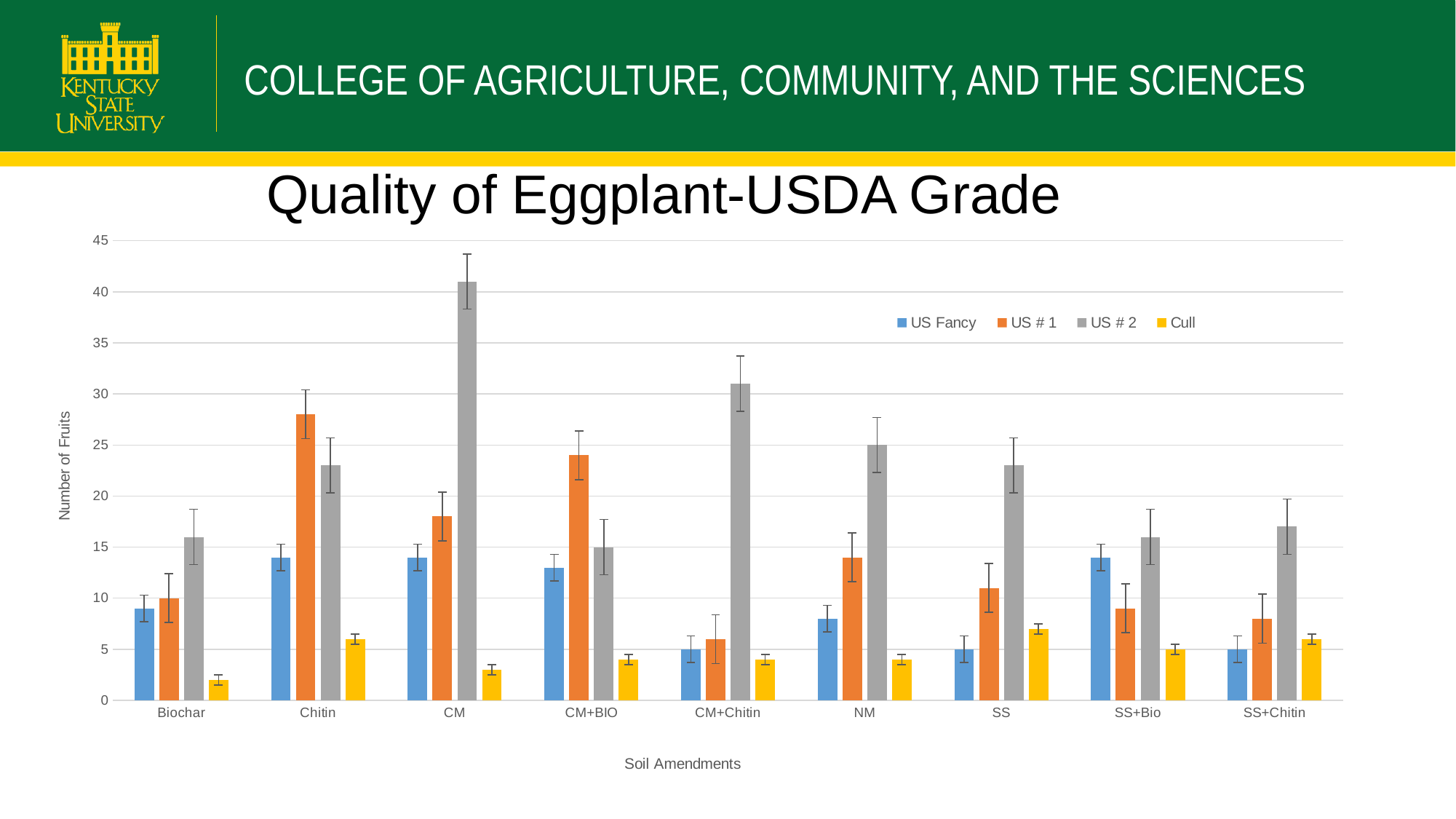
For SS+Bio, which is larger: US Fancy or US # 1? US Fancy Which soil amendment has the highest US # 2 bar? CM Is the Cull value for SS greater or less than 5? greater Is the US # 2 value for CM greater or less than 35? greater Which soil amendment has the highest US # 1 bar? Chitin Which soil amendment has the lowest Cull bar? Biochar How many series does the legend list? 4 How many soil amendments are shown on the x axis? 9 Is the US # 2 value for CM+Chitin greater or less than 25? greater What kind of chart is shown on the slide? bar chart For Chitin, which is larger: US # 1 or US # 2? US # 1 What is the title of the y axis? Number of Fruits